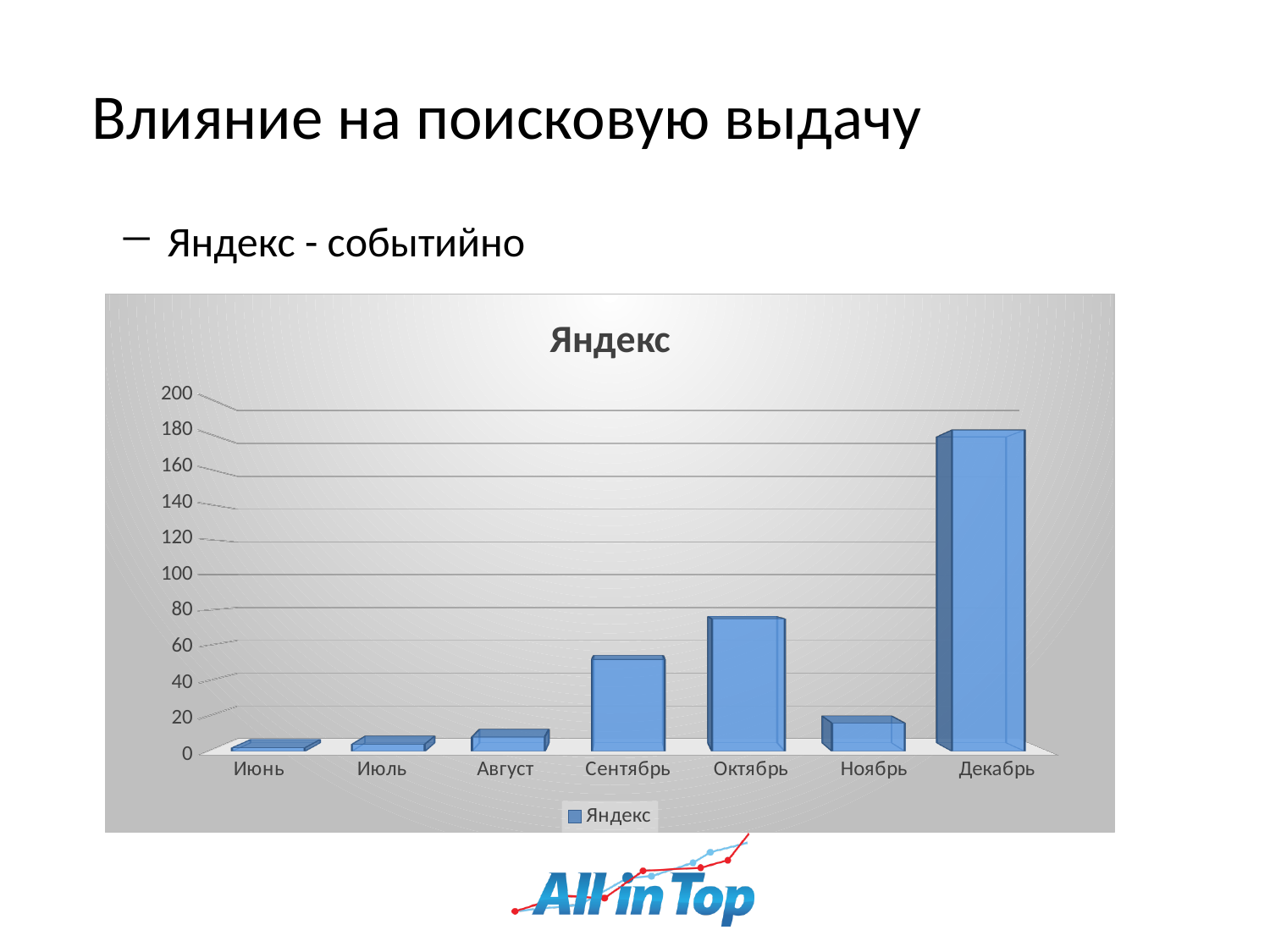
What type of chart is shown on the slide? bar chart Do the values rise or fall from Июнь to Октябрь? rise Is the value for Сентябрь greater or less than 40? greater How many series does the chart legend list? 1 Which is larger, the value for Октябрь or the value for Сентябрь? Октябрь How many categories (months) are shown on the x axis of the chart? 7 Which month has the lowest value in the chart? Июнь Which month has the highest value in the chart? Декабрь Is the value for Декабрь greater or less than 160? greater What is the title of the chart? Яндекс Is the value for Ноябрь greater or less than 40? less